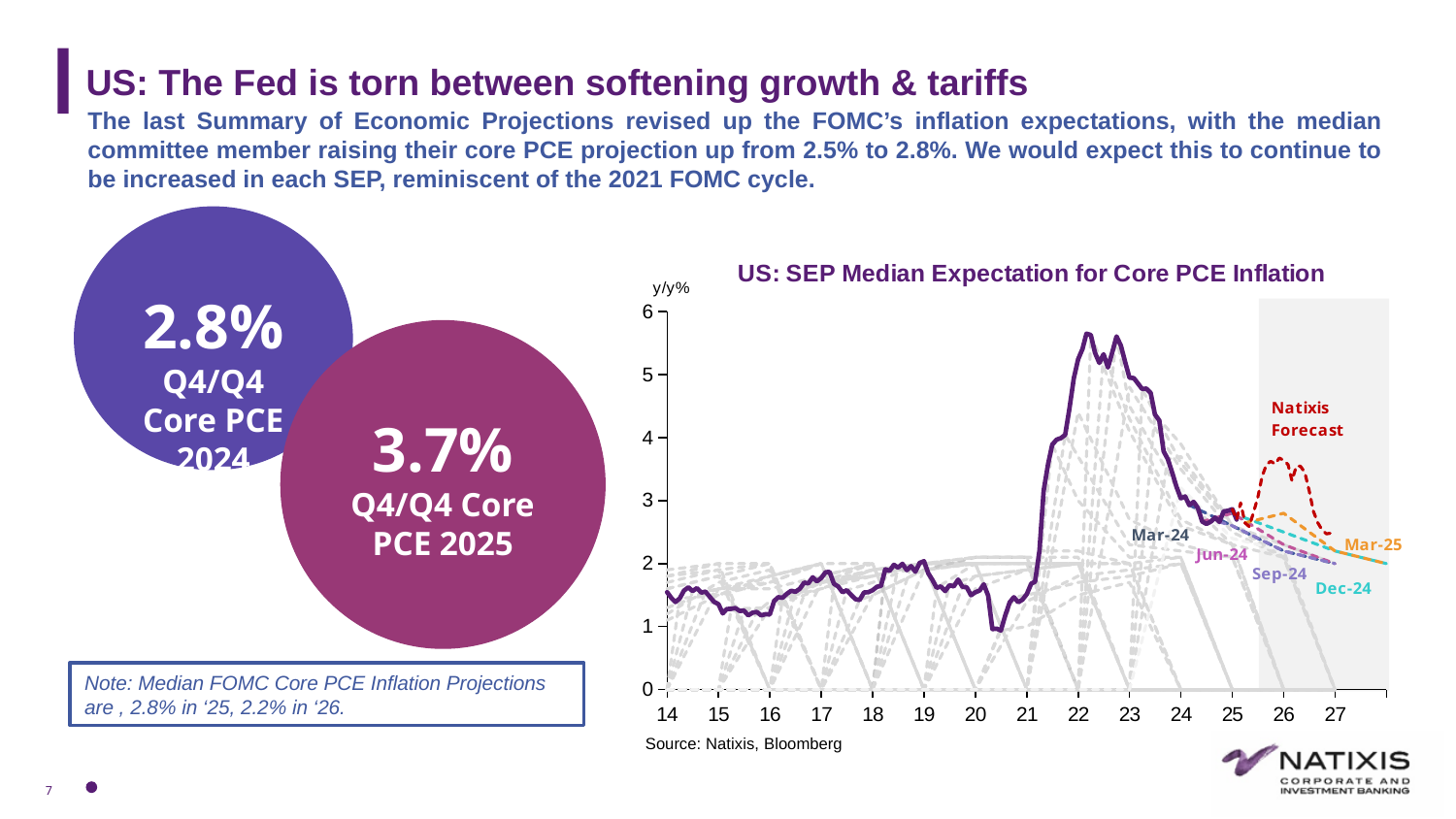
How many dated SEP projection vintages are labelled on the chart (Mar-24, Jun-24, etc.)? 5 Does the purple core PCE inflation line rise or fall between 22 and 24 on the x-axis? fall What unit is shown on the y-axis of the chart? y/y% Around which year on the x-axis does the purple core PCE inflation line reach its highest point? 22 Does the purple core PCE inflation line rise or fall between 20 and 22 on the x-axis? rise What is the title of the chart? US: SEP Median Expectation for Core PCE Inflation Is the value of the purple line at the start of the chart (2014) greater or less than 2? less Which reaches a higher peak in the forecast period: the Natixis Forecast line or the Mar-25 SEP projection line? Natixis Forecast What type of chart is shown on the slide? line chart Is the peak of the purple core PCE inflation line around 2022 greater or less than 5? greater Is the peak of the red dashed Natixis Forecast line greater or less than 3? greater